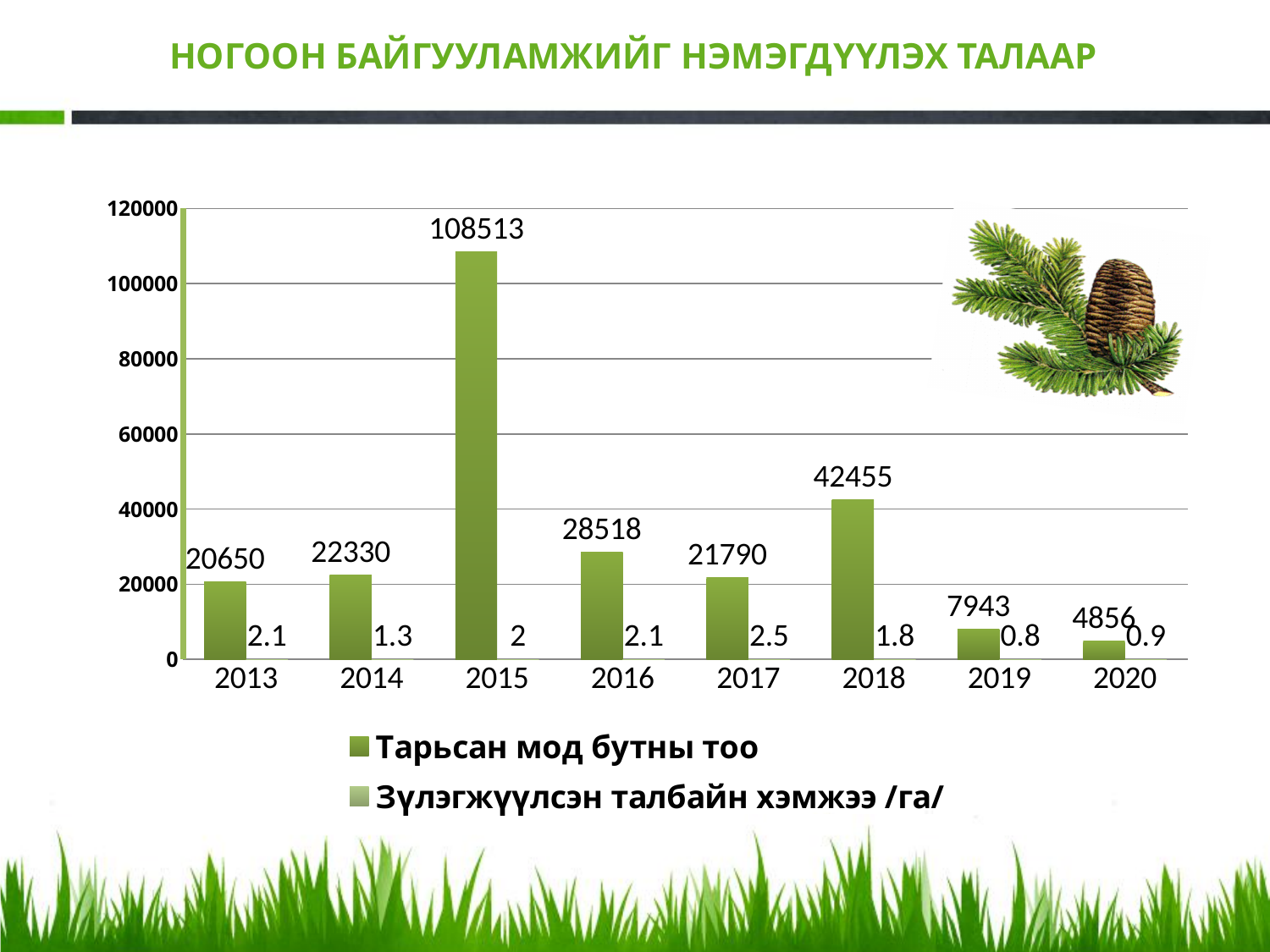
What is the value of "Тарьсан мод бутны тоо" for 2018? 42455 What is the value of "Зүлэгжүүлсэн талбайн хэмжээ /га/" for 2017? 2.5 What kind of chart is shown on the slide? bar chart What is the value of "Тарьсан мод бутны тоо" for 2015? 108513 What is the difference between the "Тарьсан мод бутны тоо" values for 2018 and 2019? 34512 What is the value of "Зүлэгжүүлсэн талбайн хэмжээ /га/" for 2019? 0.8 How many years are shown on the x axis of the chart? 8 Which year has the larger "Тарьсан мод бутны тоо" value, 2014 or 2016? 2016 How many series does the chart legend list? 2 Which year has the highest value for "Тарьсан мод бутны тоо"? 2015 Is the value of "Тарьсан мод бутны тоо" for 2015 greater or less than 100000? greater Which year has the lowest value for "Тарьсан мод бутны тоо"? 2020